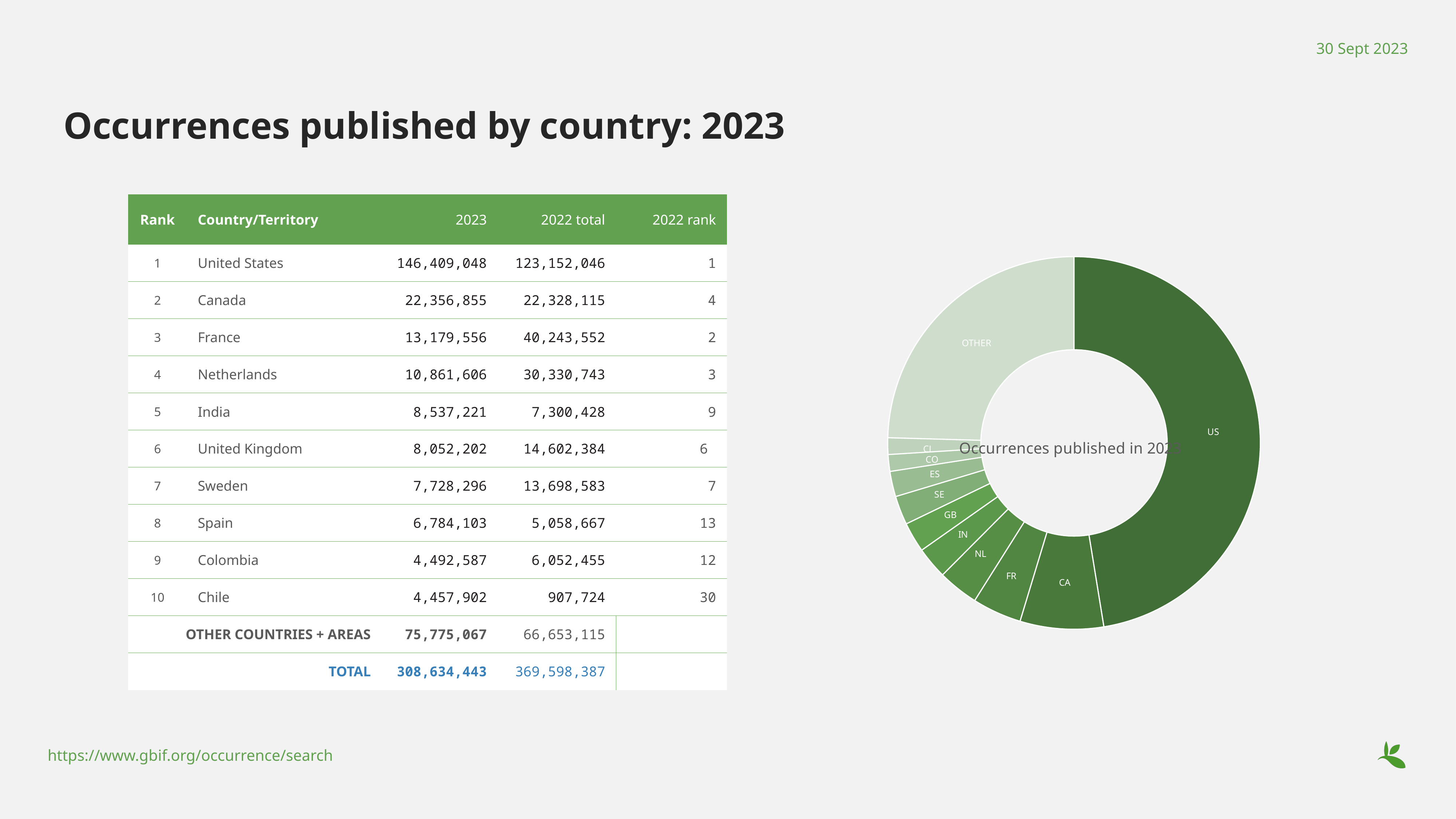
Which slice of the donut chart is the largest? US What is the total of all slices in the donut chart (total occurrences published in 2023)? 308,634,443 What is the difference between the 2023 values of the US and CA slices in the donut chart? 124,052,193 What is the 2023 value represented by the OTHER slice of the donut chart? 75,775,067 What is the 2023 value represented by the CA slice of the donut chart? 22,356,855 What kind of chart is shown on the right of the slide? Pie (donut) chart In the donut chart, which slice is larger, US or OTHER? US In the donut chart, which slice is larger, NL or GB? NL How many slices does the donut chart have? 11 In the donut chart, which slice is larger, CA or FR? CA What is the 2023 value represented by the US slice of the donut chart? 146,409,048 What is the title printed in the centre of the donut chart? Occurrences published in 2023